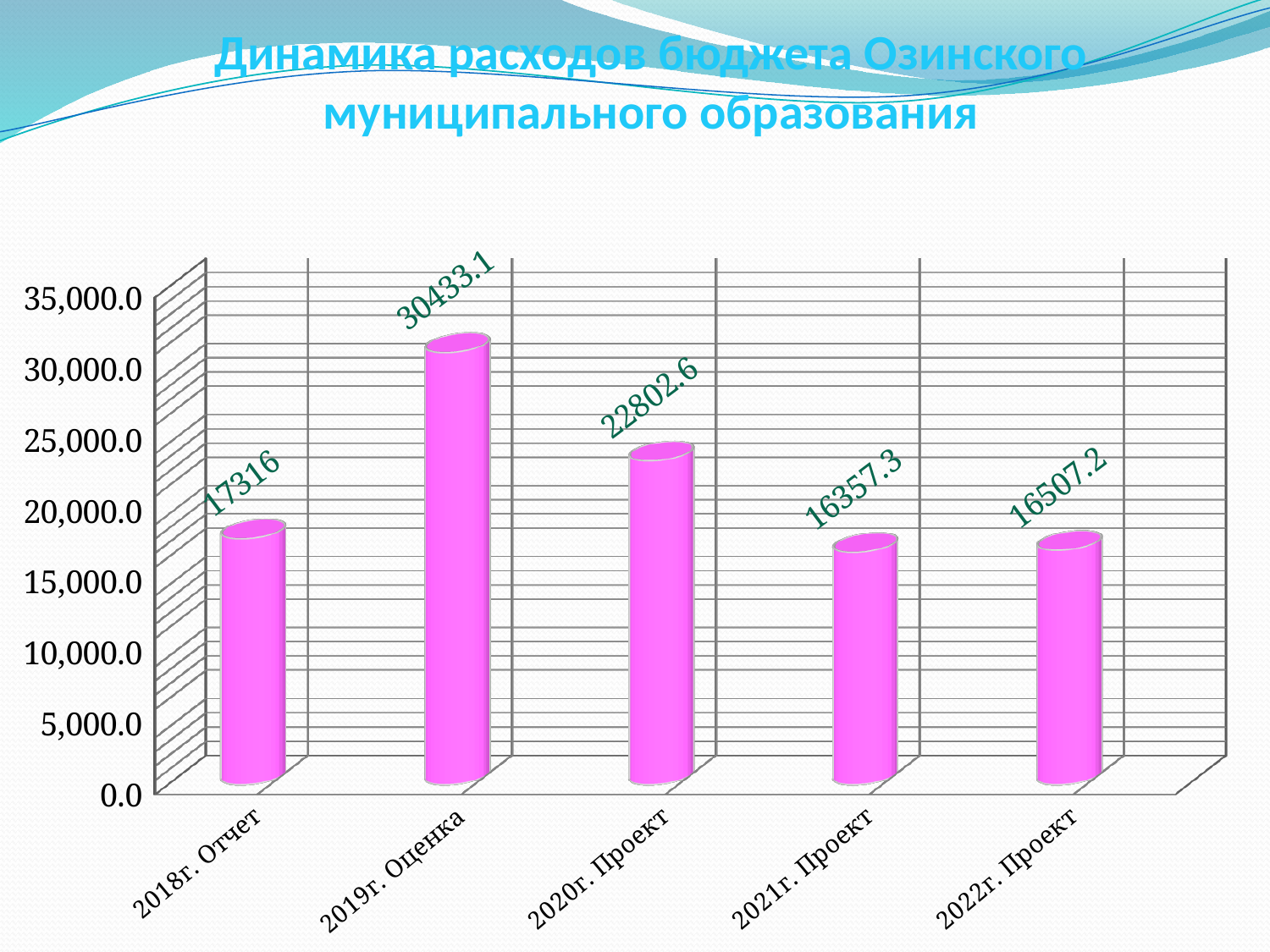
Do the values rise or fall from 2019г. Оценка to 2021г. Проект? fall Is the value for 2022г. Проект greater or less than 20,000.0? less What is the value for 2018г. Отчет? 17316 Which is larger, the value for 2020г. Проект or the value for 2018г. Отчет? 2020г. Проект What is the value for 2021г. Проект? 16357.3 What is the value for 2019г. Оценка? 30433.1 What is the difference between the values for 2019г. Оценка and 2018г. Отчет? 13117.1 How many categories are shown on the x axis? 5 What kind of chart is shown on the slide? bar chart Which category has the highest value? 2019г. Оценка What is the difference between the values for 2020г. Проект and 2021г. Проект? 6445.3 Which category has the lowest value? 2021г. Проект